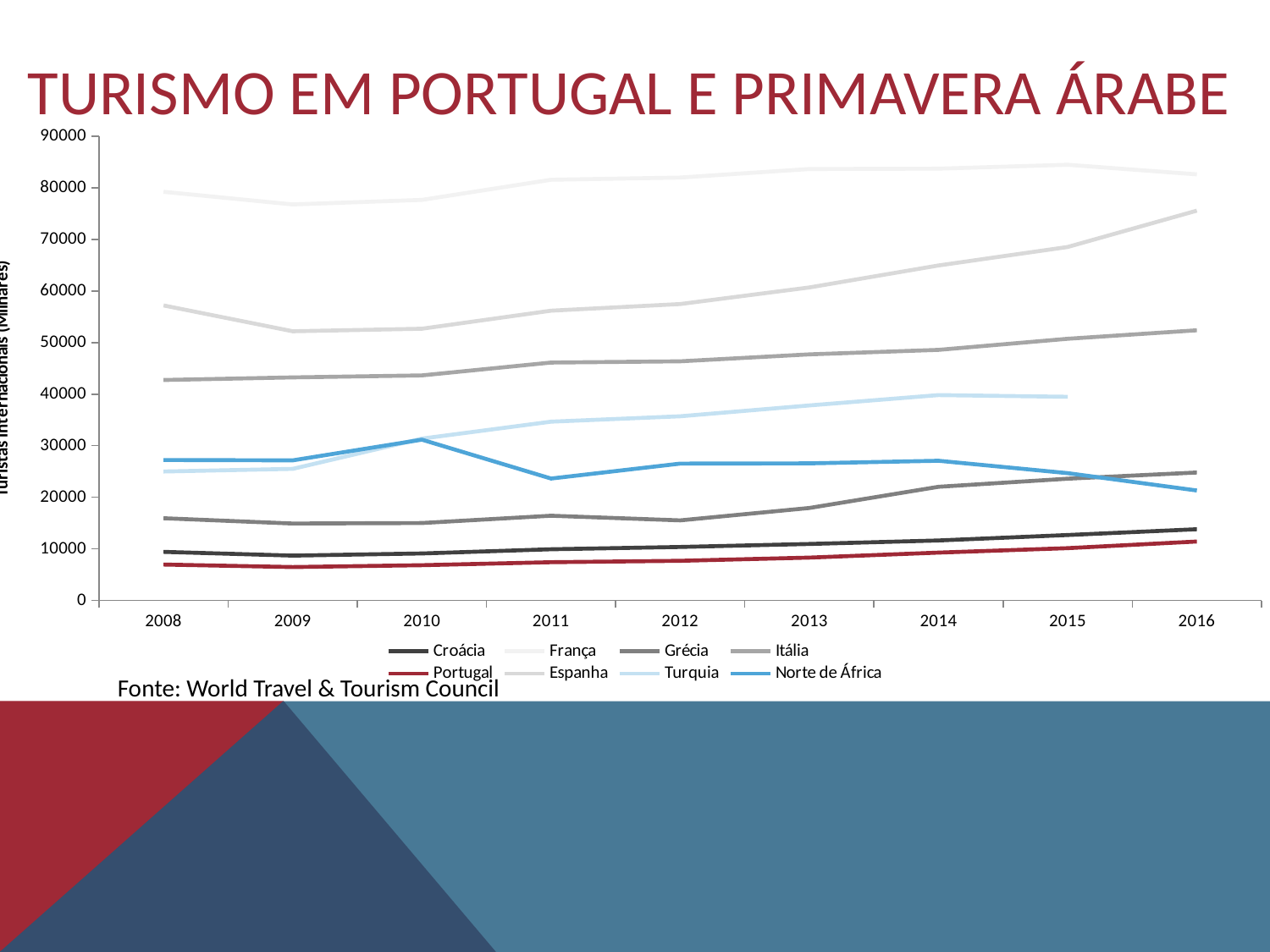
Is the value for Portugal in 2016 greater or less than 20000? less Is the value for Espanha in 2016 greater or less than 70000? greater How many series does the legend list? 8 What is the title of the slide? TURISMO EM PORTUGAL E PRIMAVERA ÁRABE Is the value for Norte de África in 2011 greater or less than 30000? less What kind of chart is shown on the slide? line chart How many years are shown along the x axis? 9 Which series has the lowest value in 2016? Portugal Which series has the highest values across the whole chart? França Does the Espanha line rise or fall from 2009 to 2016? rise Which is larger in 2015, Turquia or Norte de África? Turquia